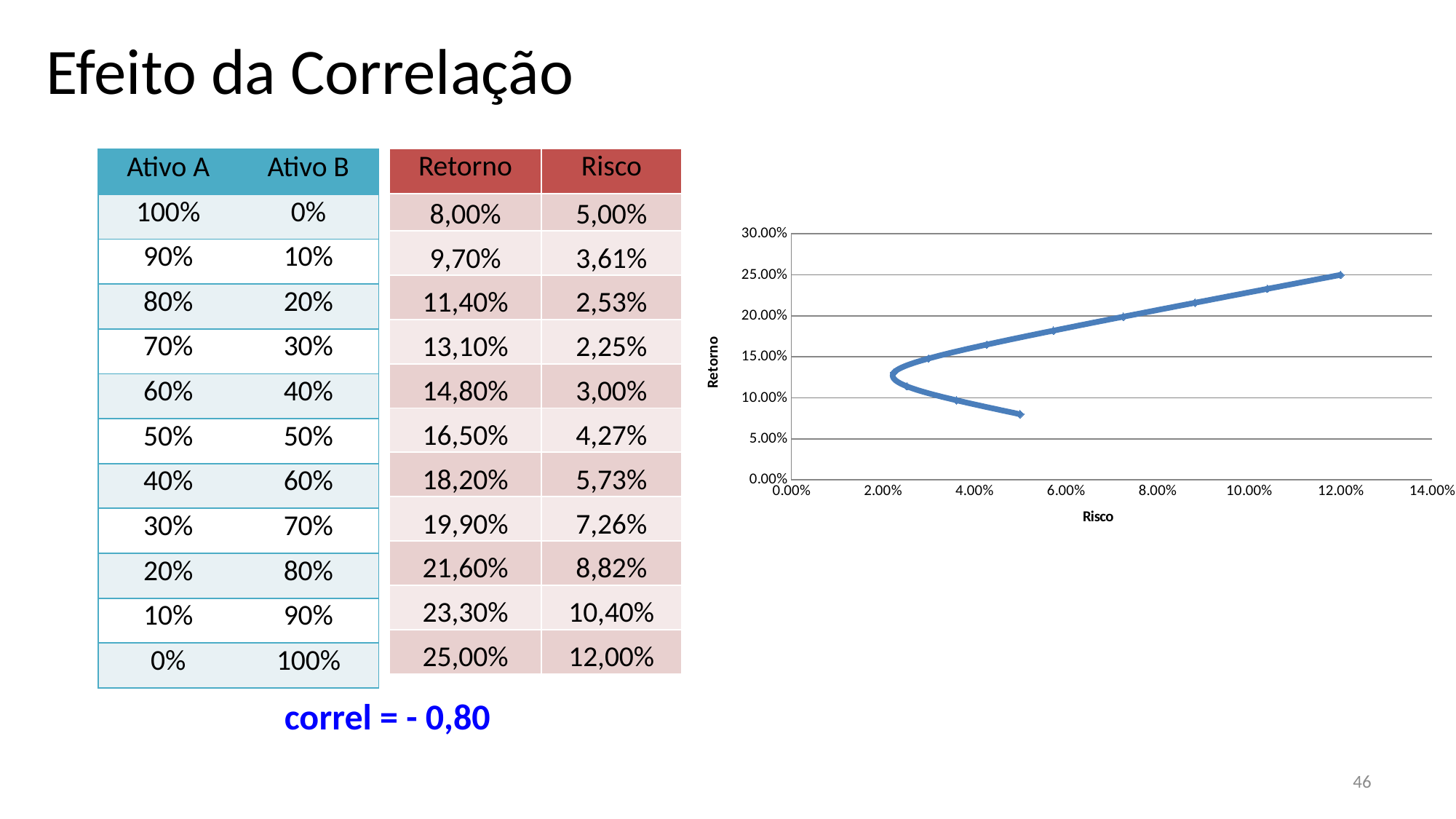
Is the Retorno of the highest point on the chart greater or less than 20.00%? greater Is the Risco of the leftmost point on the curve greater or less than 4.00%? less What is the lowest Risco value among the plotted points? 2,25% Which point has the higher Retorno: the one with Risco 5,00% or the one with Risco 12,00%? Risco 12,00% What is the label of the vertical axis of the chart? Retorno What kind of chart is shown on the right of the slide? scatter chart with a smoothed line Along the upper branch of the curve, does Retorno rise or fall as Risco increases? rise Is the Risco of the point with the lowest Retorno greater or less than 4.00%? greater What is the Retorno of the point with Risco 12,00%? 25,00% What is the highest Retorno value among the plotted points? 25,00% What is the label of the horizontal axis of the chart? Risco How many data points are plotted on the chart? 11